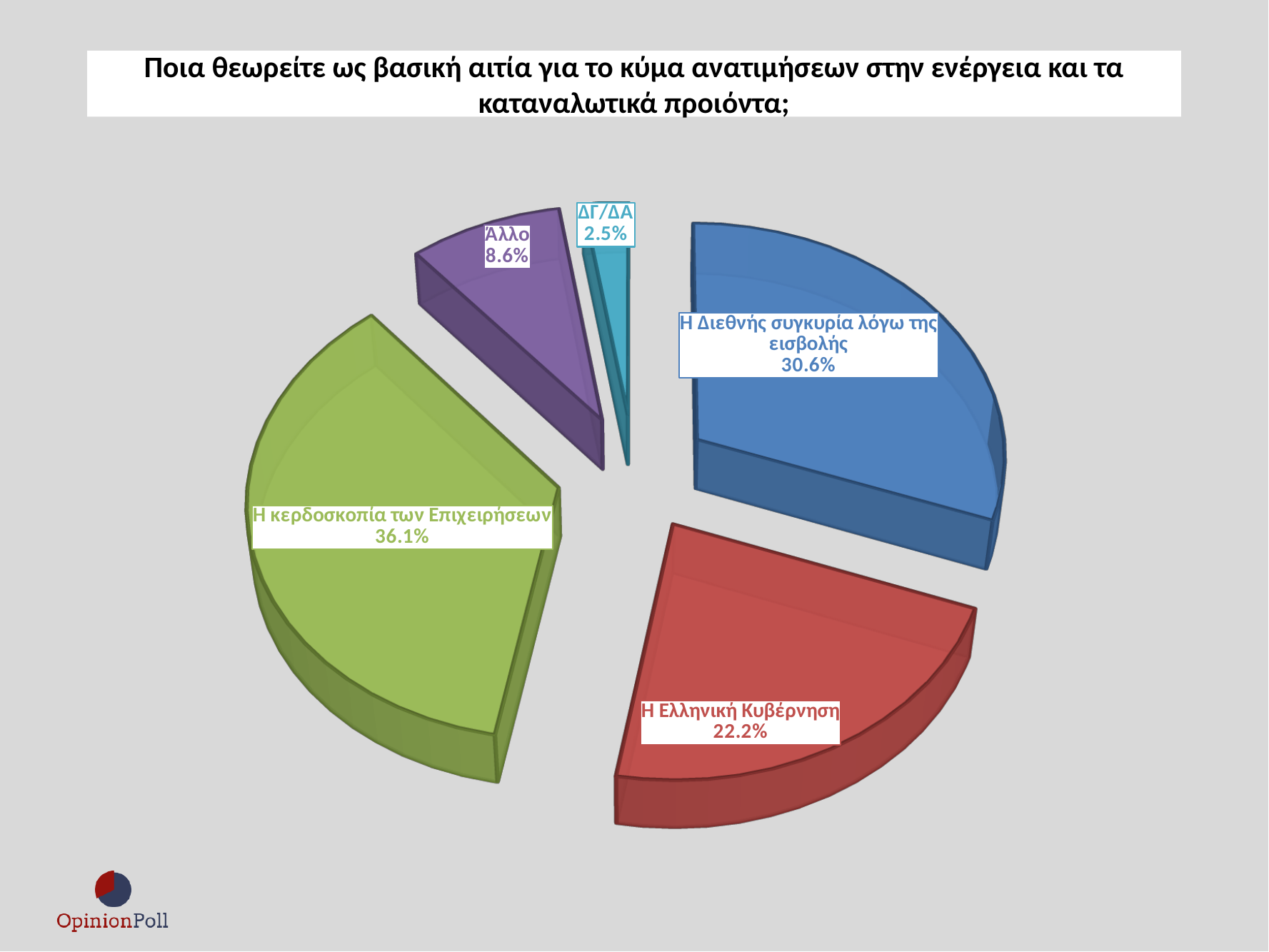
What kind of chart is shown on the slide? Pie chart What is the difference between the shares for 'Η κερδοσκοπία των Επιχειρήσεων' and 'Η Διεθνής συγκυρία λόγω της εισβολής'? 5.5% Which category has the smallest share of the pie? ΔΓ/ΔΑ What share of the pie does 'Η κερδοσκοπία των Επιχειρήσεων' hold? 36.1% What is the value for the 'ΔΓ/ΔΑ' slice? 2.5% What colour is the slice for 'Η Ελληνική Κυβέρνηση'? Red Which is larger: the share for 'Η Ελληνική Κυβέρνηση' or the share for 'Άλλο'? Η Ελληνική Κυβέρνηση What percentage is shown for 'Η Διεθνής συγκυρία λόγω της εισβολής'? 30.6% How many slices does the pie chart have? 5 What is the value for the 'Άλλο' slice? 8.6% What is the value shown for 'Η Ελληνική Κυβέρνηση'? 22.2% Which category has the largest share of the pie? Η κερδοσκοπία των Επιχειρήσεων